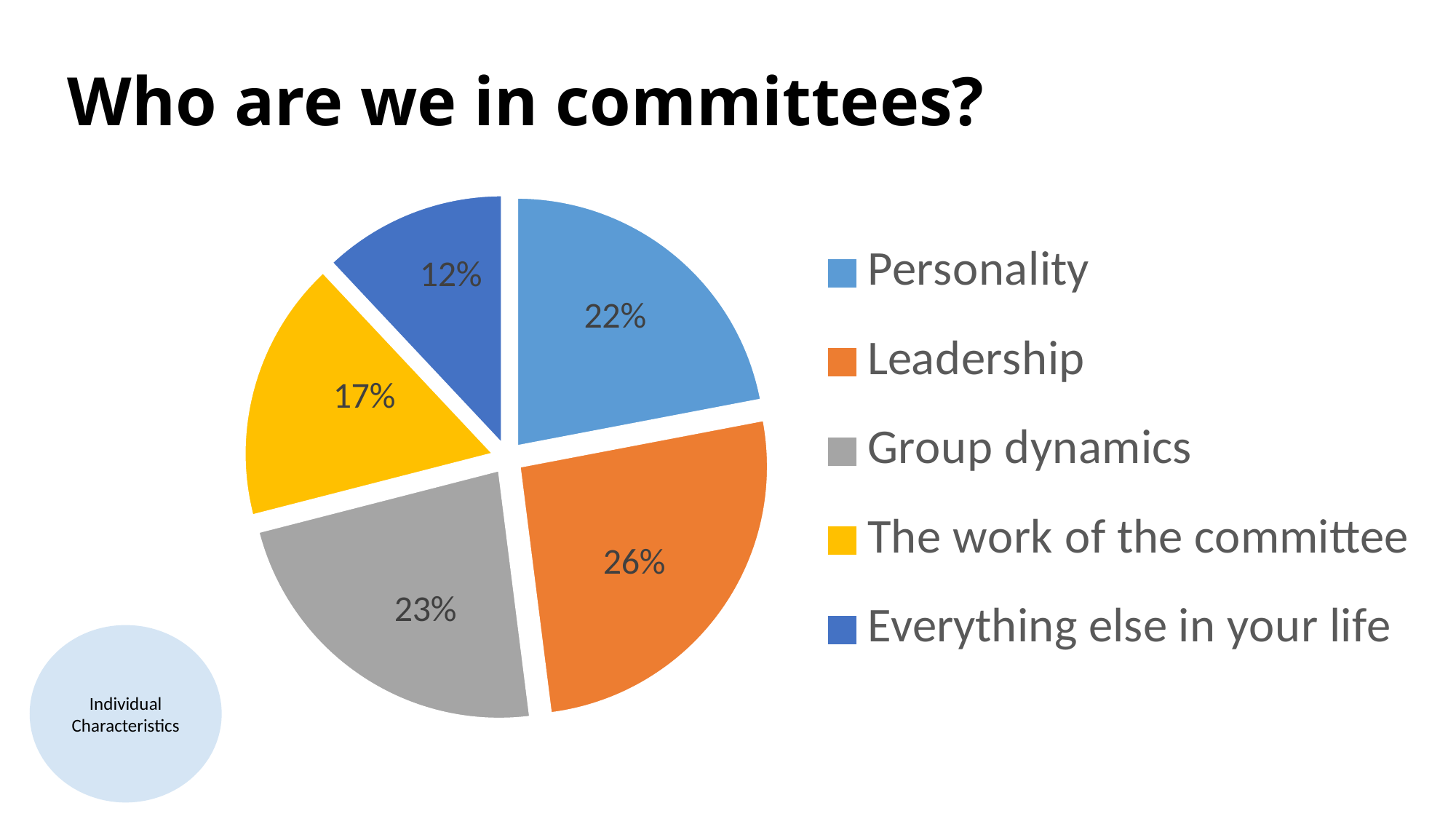
Which category has the smallest slice of the pie? Everything else in your life What share of the pie does The work of the committee have? 17% What is the difference between the Leadership share and the Everything else in your life share? 14% How many slices does the pie chart have? 5 What share of the pie does Everything else in your life have? 12% What share of the pie does Leadership have? 26% Which category has the largest slice of the pie? Leadership What share of the pie does Group dynamics have? 23% Which is larger, the share for Group dynamics or the share for The work of the committee? Group dynamics What share of the pie does Personality have? 22% What kind of chart is shown on the slide? Pie chart What colour is the slice for The work of the committee? Yellow